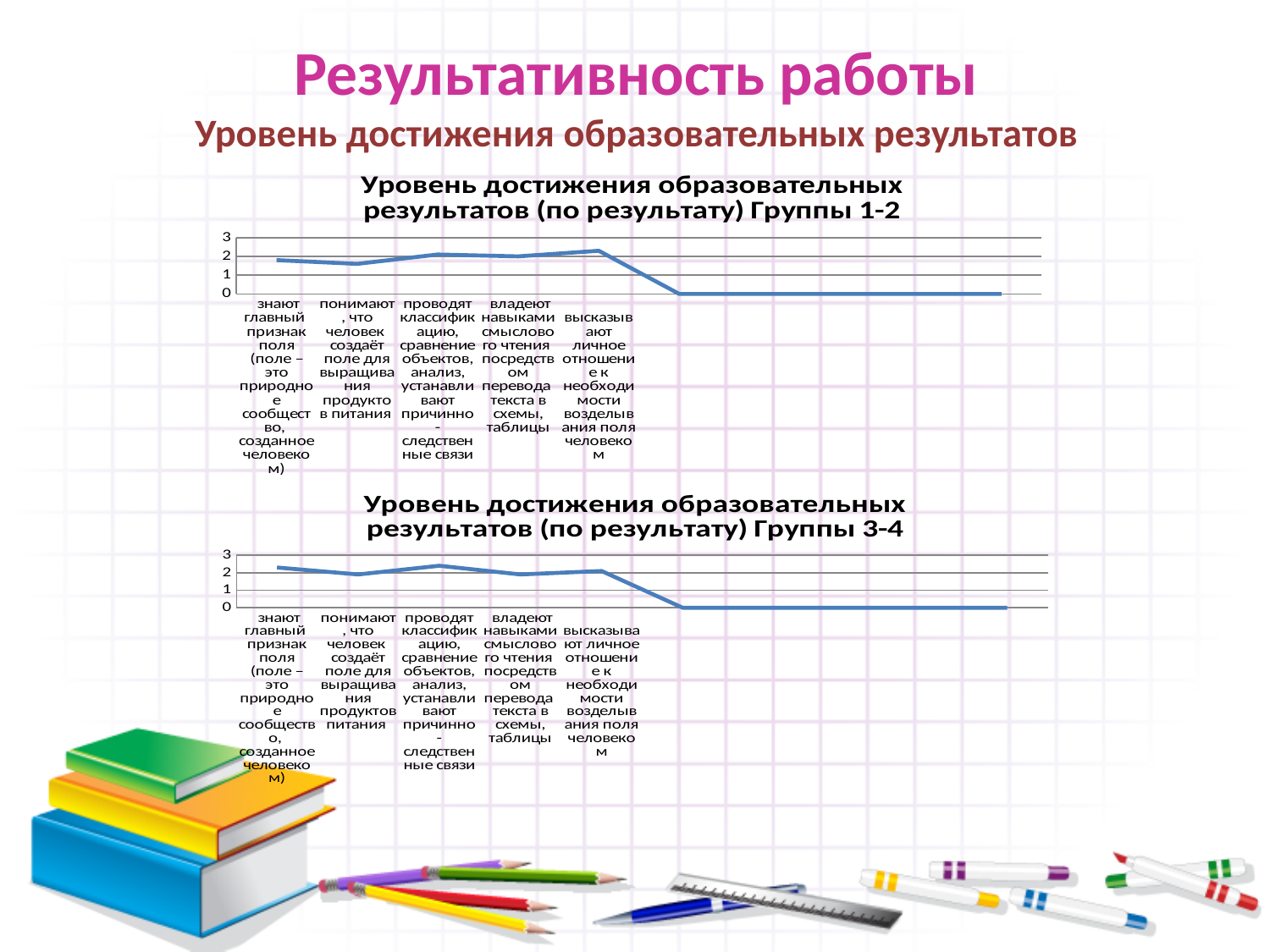
What kind of chart is the bottom chart, 'Уровень достижения образовательных результатов (по результату) Группы 3-4'? line chart What is the highest value shown on the y axis of the top chart (Группы 1-2)? 3 What is the title of the bottom chart on the slide? Уровень достижения образовательных результатов (по результату) Группы 3-4 What kind of chart is the top chart, 'Уровень достижения образовательных результатов (по результату) Группы 1-2'? line chart In the top chart (Группы 1-2), is the value for 'высказывают личное отношение к необходимости возделывания поля человеком' greater or less than 2? greater In the bottom chart (Группы 3-4), which is larger: the value for 'понимают, что человек создаёт поле для выращивания продуктов питания' or for 'проводят классификацию, сравнение объектов, анализ, устанавливают причинно-следственные связи'? проводят классификацию, сравнение объектов, анализ, устанавливают причинно-следственные связи In the top chart (Группы 1-2), which is larger: the value for 'понимают, что человек создаёт поле для выращивания продуктов питания' or for 'высказывают личное отношение к необходимости возделывания поля человеком'? высказывают личное отношение к необходимости возделывания поля человеком In the top chart (Группы 1-2), do the values overall rise or fall from the first point to the last point along the x axis? fall In the top chart (Группы 1-2), is the value for 'понимают, что человек создаёт поле для выращивания продуктов питания' greater or less than 2? less In the top chart (Группы 1-2), is the value for 'знают главный признак поля' greater or less than 2? less In the bottom chart (Группы 3-4), which of the labeled categories has the highest value? проводят классификацию, сравнение объектов, анализ, устанавливают причинно-следственные связи